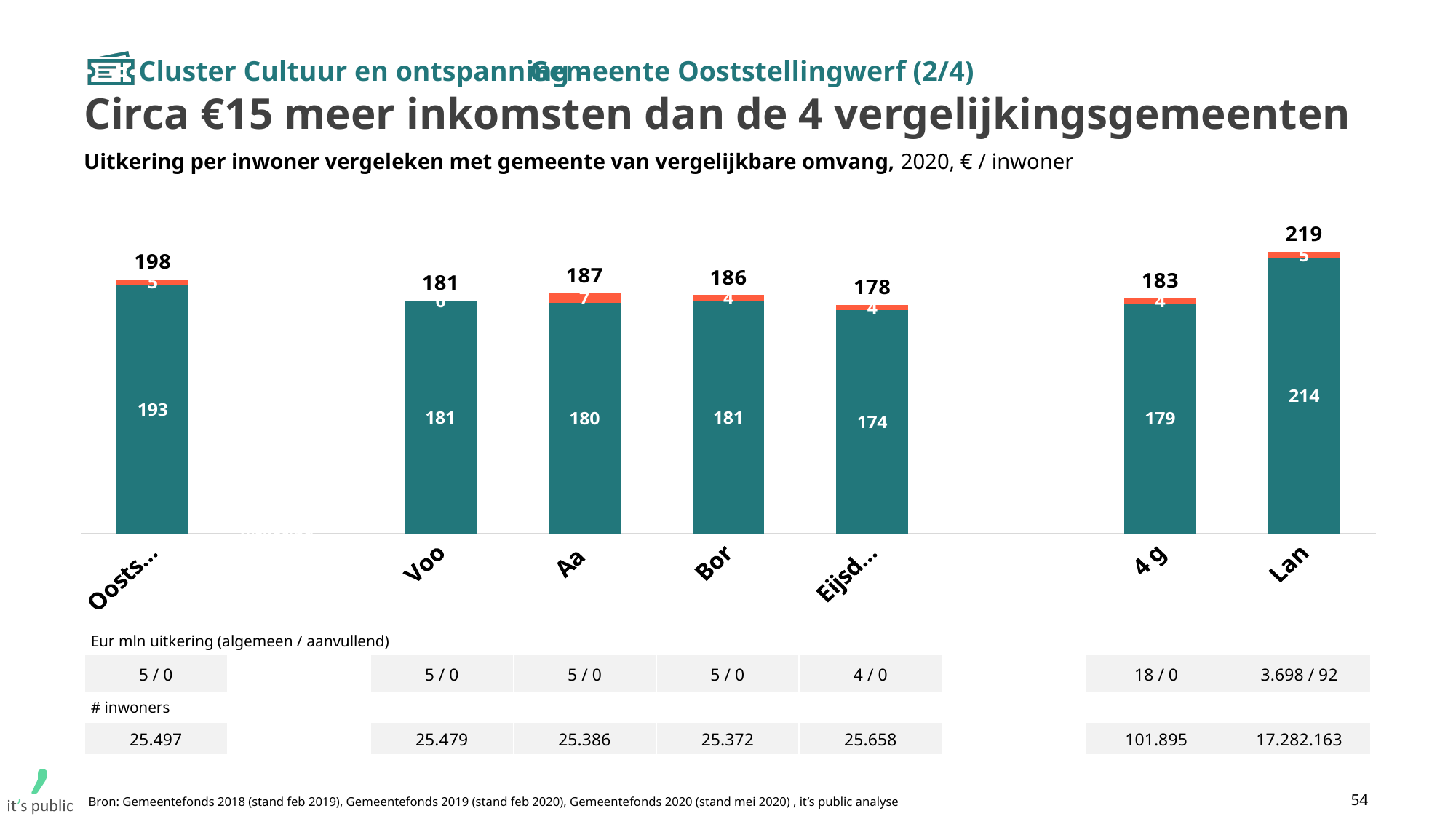
What kind of chart is shown on the slide? Stacked bar chart What is the value of the orange (upper) segment of the bar labelled "Aa"? 7 What is the difference between the total for "Oosts..." and the total for "4 g"? 15 What is the value of the teal (lower) segment of the bar labelled "Eijsd..."? 174 How many bars are plotted in the chart? 7 What is the total of the stacked bar labelled "Voo"? 181 What unit is stated in the chart title for the plotted values? € / inwoner What is the total value shown above the bar labelled "Oosts..."? 198 Which bar has the lowest total value? Eijsd... What is the total value shown above the bar labelled "Lan"? 219 Which bar has the highest total value? Lan Which has a larger total value, "Aa" or "Bor"? Aa